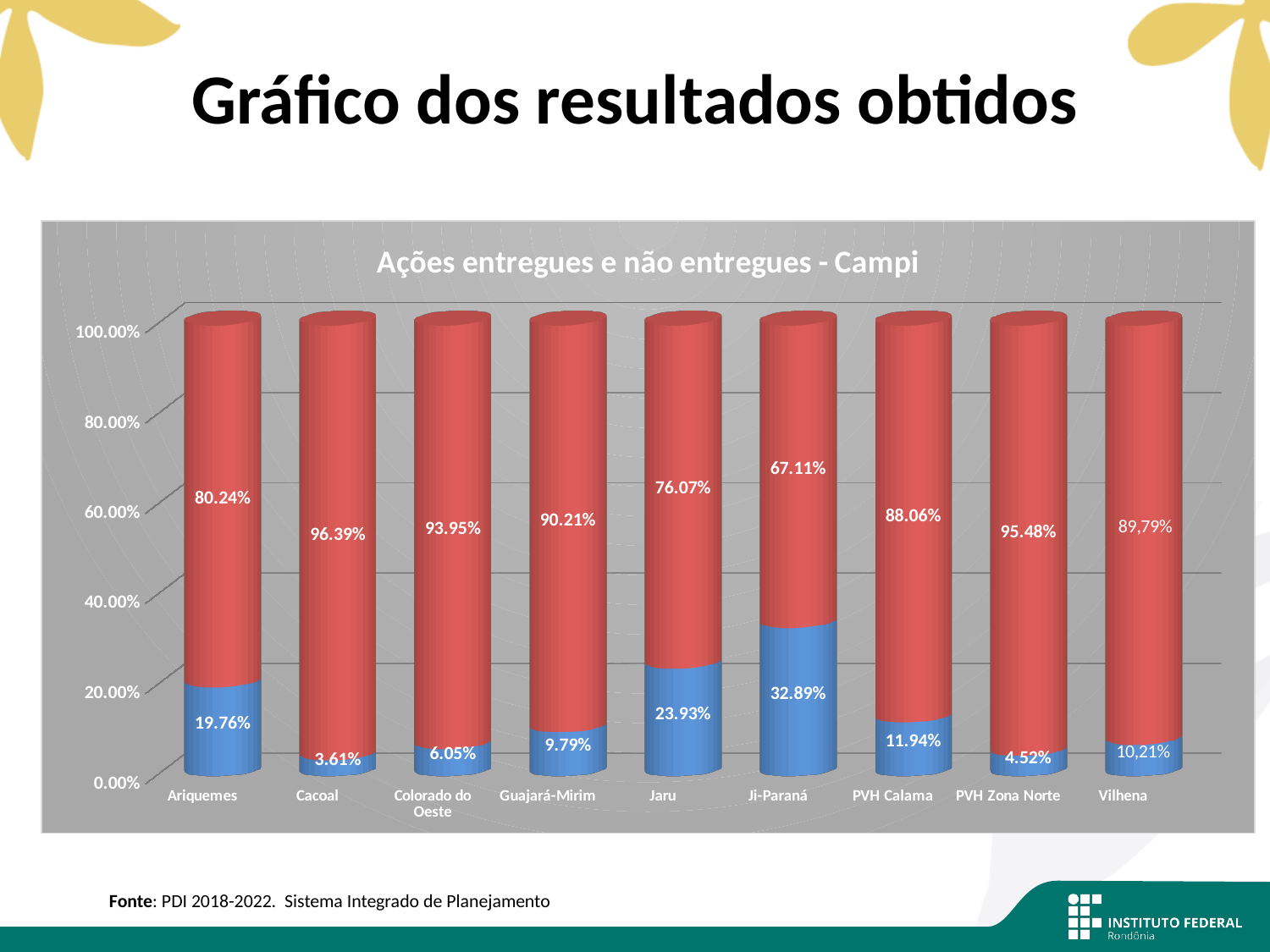
How many campi (categories) are shown on the x axis of the chart? 9 Which is larger, the blue segment for PVH Calama or the blue segment for Guajará-Mirim? PVH Calama Which campus has the lowest red segment value? Ji-Paraná What is the value of the blue segment for Ji-Paraná? 32.89% What is the value of the red segment for Cacoal? 96.39% Which campus has the highest blue segment value? Ji-Paraná What type of chart is shown on the slide? Stacked bar chart What is the difference between the blue segment values of Jaru and Ariquemes? 4.17% What is the total of the stacked bar for Colorado do Oeste? 100.00% What is the value of the blue segment for Vilhena? 10,21% Which campus has the lowest blue segment value? Cacoal What is the title of the chart? Ações entregues e não entregues - Campi